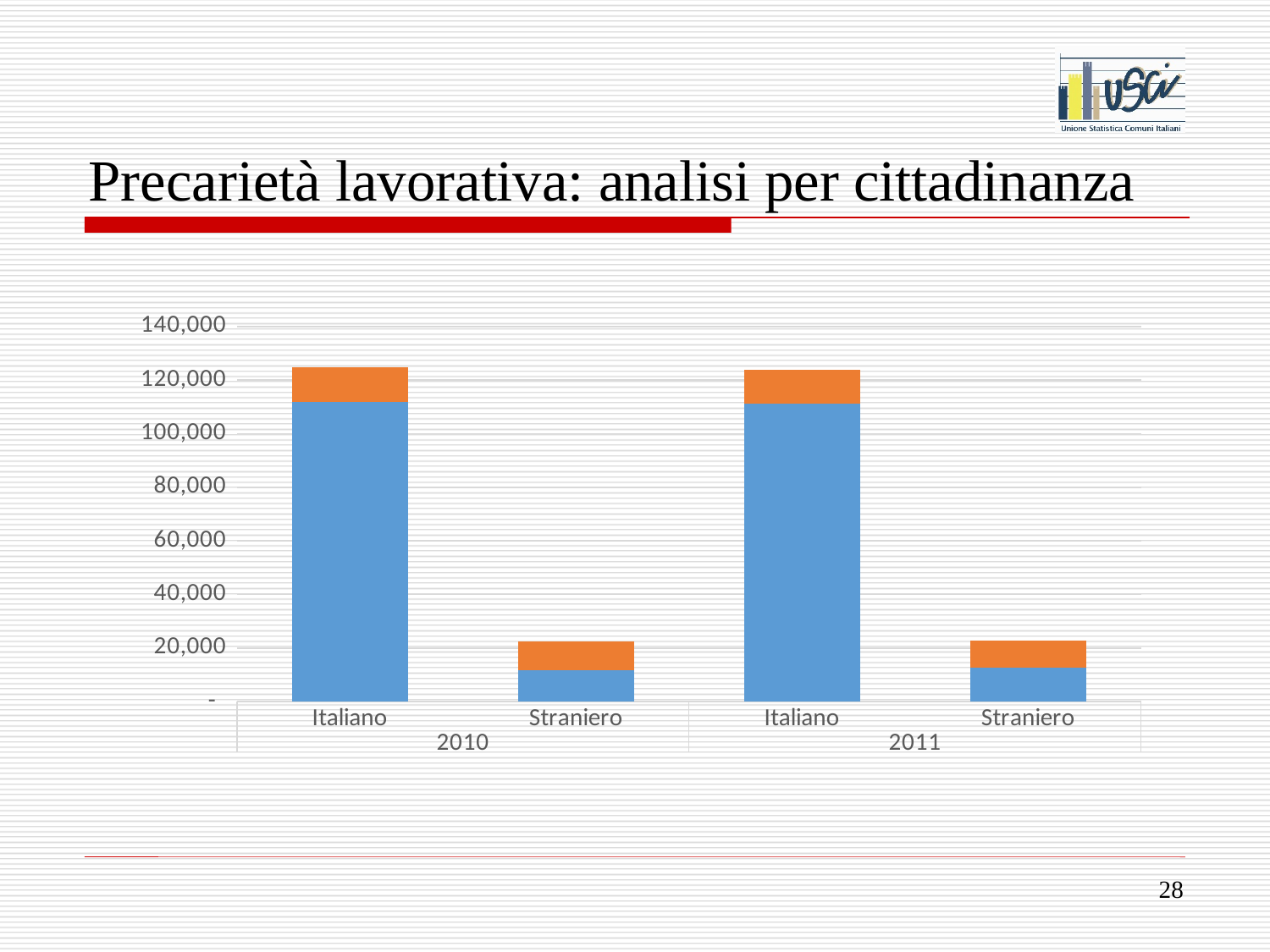
How many bars are plotted in the chart? 4 In 2010, which bar is taller, Italiano or Straniero? Italiano What kind of chart is shown on the slide? bar chart Is the total value for Straniero in 2011 greater or less than 40,000? less Is the blue segment for Straniero in 2011 greater or less than 20,000? less What is the title of the slide containing the chart? Precarietà lavorativa: analisi per cittadinanza Is the blue segment for Italiano in 2010 greater or less than 100,000? greater In 2011, which bar is taller, Italiano or Straniero? Italiano Which two years are shown on the x axis of the chart? 2010 and 2011